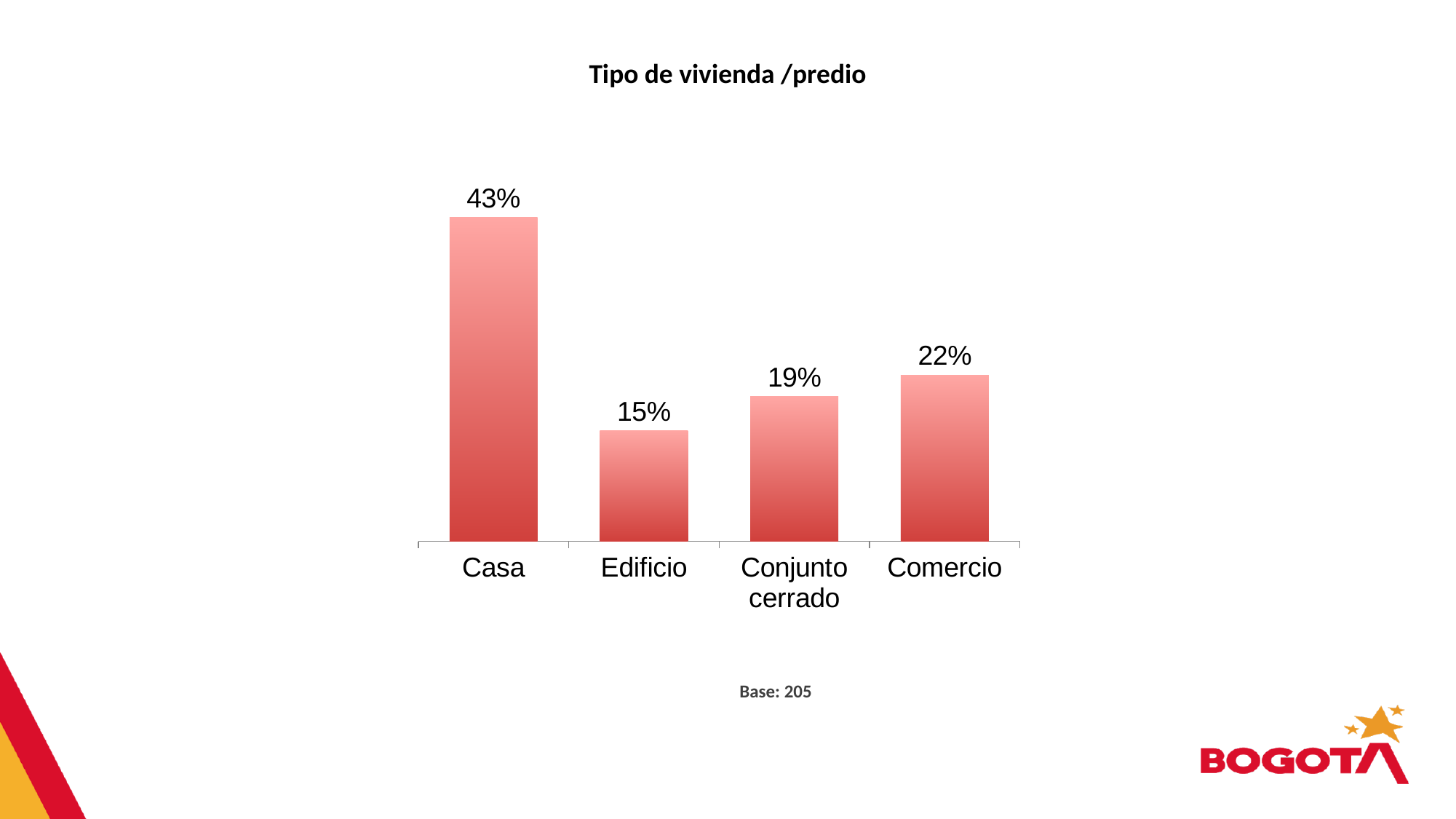
Which is larger, the value for Comercio or the value for Conjunto cerrado? Comercio What is the value for Conjunto cerrado? 19% How many categories are shown in the chart? 4 What is the difference between the values for Conjunto cerrado and Edificio? 4% Which category has the lowest value? Edificio What is the title of the chart? Tipo de vivienda /predio What is the difference between the values for Casa and Comercio? 21% What is the value for Comercio? 22% What kind of chart is shown on the slide? Bar chart Which category has the highest value? Casa What is the value for Edificio? 15% What is the value for Casa? 43%